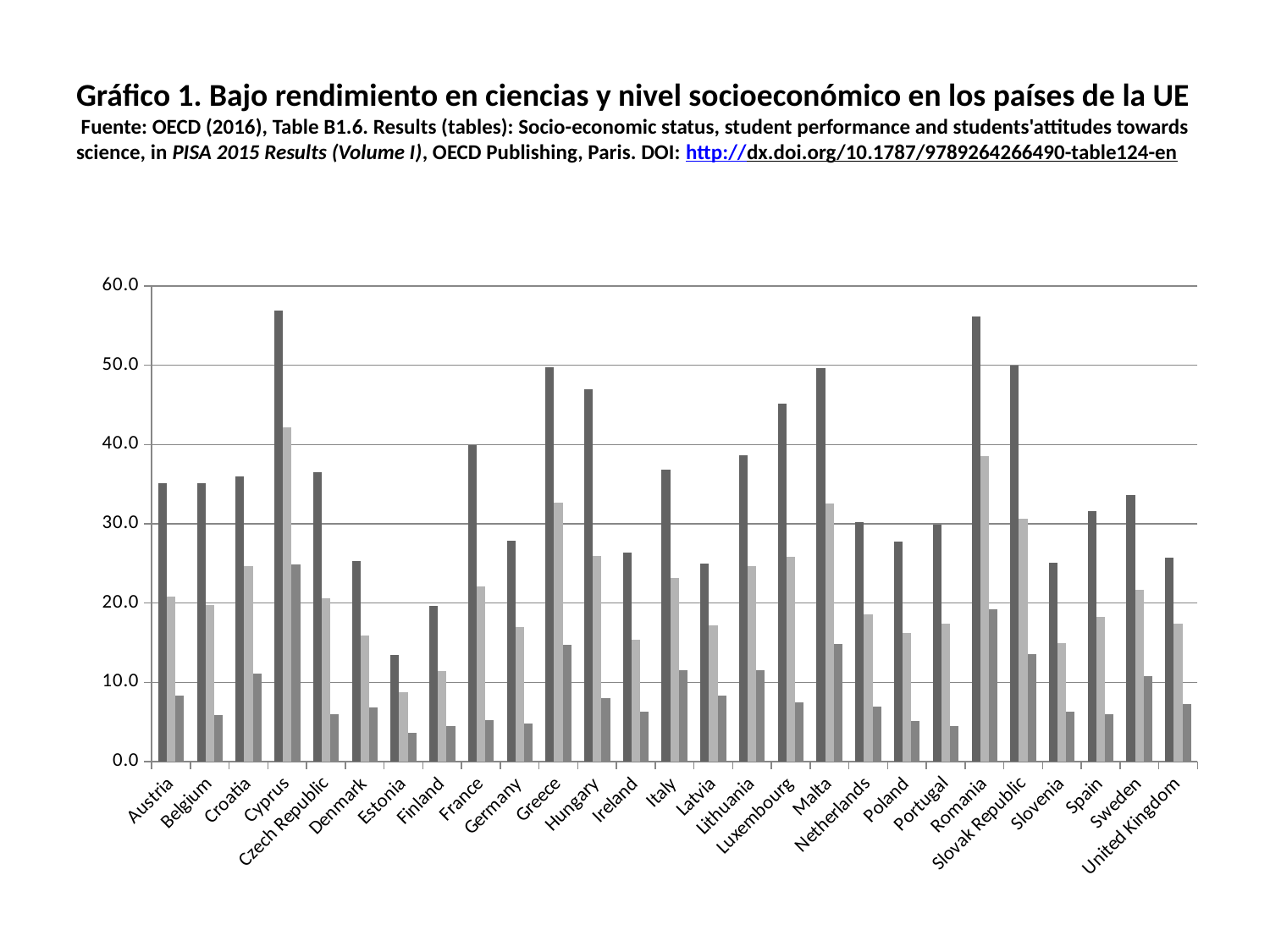
Is the value of the darkest (first) bar for Romania greater or less than 50? greater Which country has the larger darkest (first) bar, Estonia or Finland? Finland Is the value of the darkest (first) bar for Estonia greater or less than 20? less Is the value of the darkest (first) bar for Hungary greater or less than 40? greater Which country has the lowest value for the darkest (first) bar? Estonia What kind of chart is shown on the slide? bar chart Which country has the larger darkest (first) bar, Cyprus or Austria? Cyprus How many countries are shown on the x axis of the chart? 27 What is the title of the chart on the slide? Gráfico 1. Bajo rendimiento en ciencias y nivel socioeconómico en los países de la UE How many bars are plotted for each country in the chart? 3